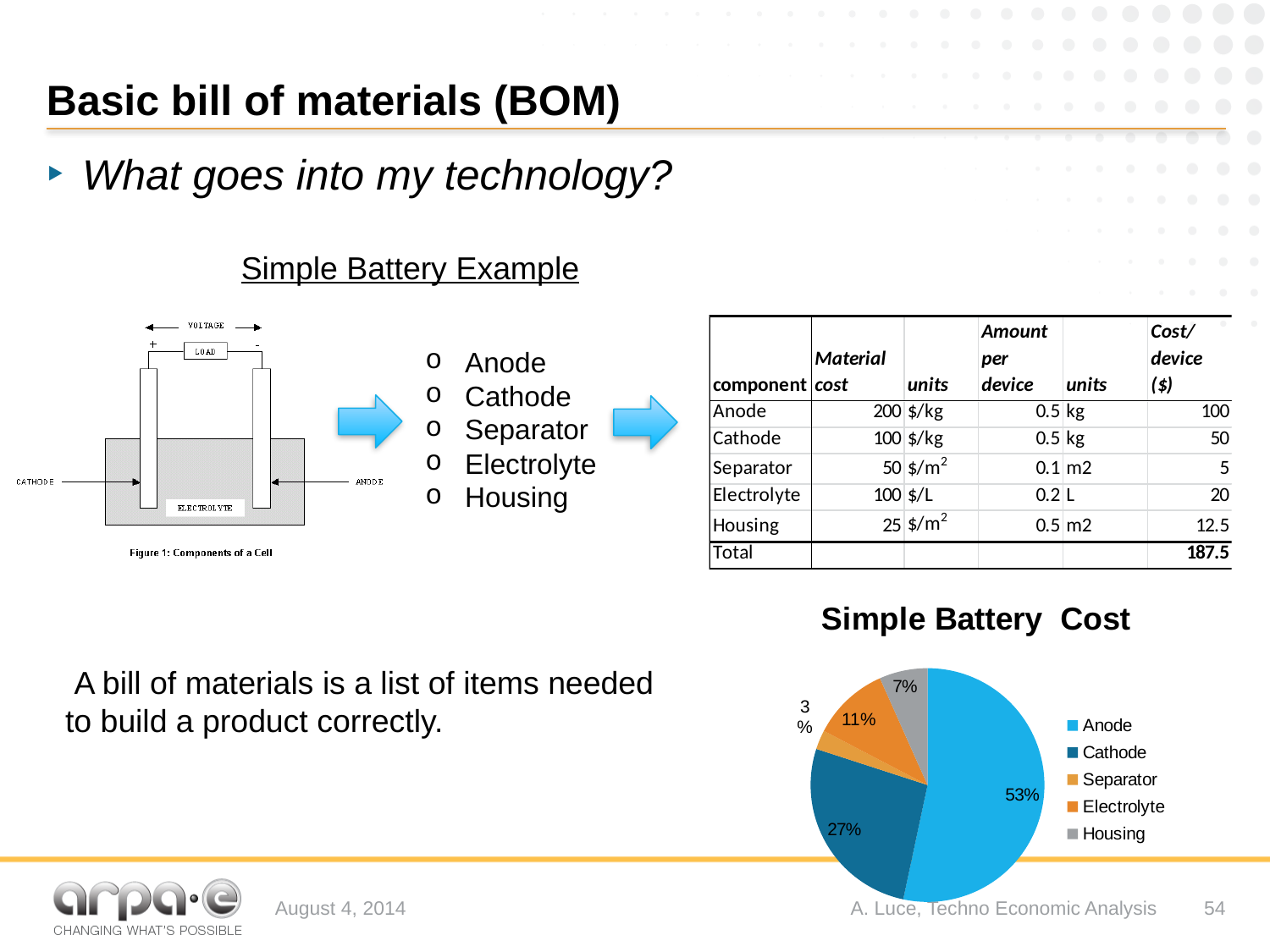
In the "Simple Battery Cost" pie chart, what percentage is shown for Housing? 7% In the "Simple Battery Cost" pie chart, what share does Anode have? 53% In the "Simple Battery Cost" pie chart, which component has the largest share? Anode In the "Simple Battery Cost" pie chart, what percentage is shown for Cathode? 27% In the "Simple Battery Cost" pie chart, which has the larger share, Cathode or Electrolyte? Cathode In the "Simple Battery Cost" pie chart, what is the difference in percentage points between the Anode and Cathode shares? 26% In the "Simple Battery Cost" pie chart, what percentage is shown for Electrolyte? 11% What is the title of the pie chart on the slide? Simple Battery Cost In the "Simple Battery Cost" pie chart, which component has the smallest share? Separator In the "Simple Battery Cost" pie chart, what percentage is shown for Separator? 3% What kind of chart is the "Simple Battery Cost" chart? pie chart How many entries does the legend of the "Simple Battery Cost" pie chart list? 5